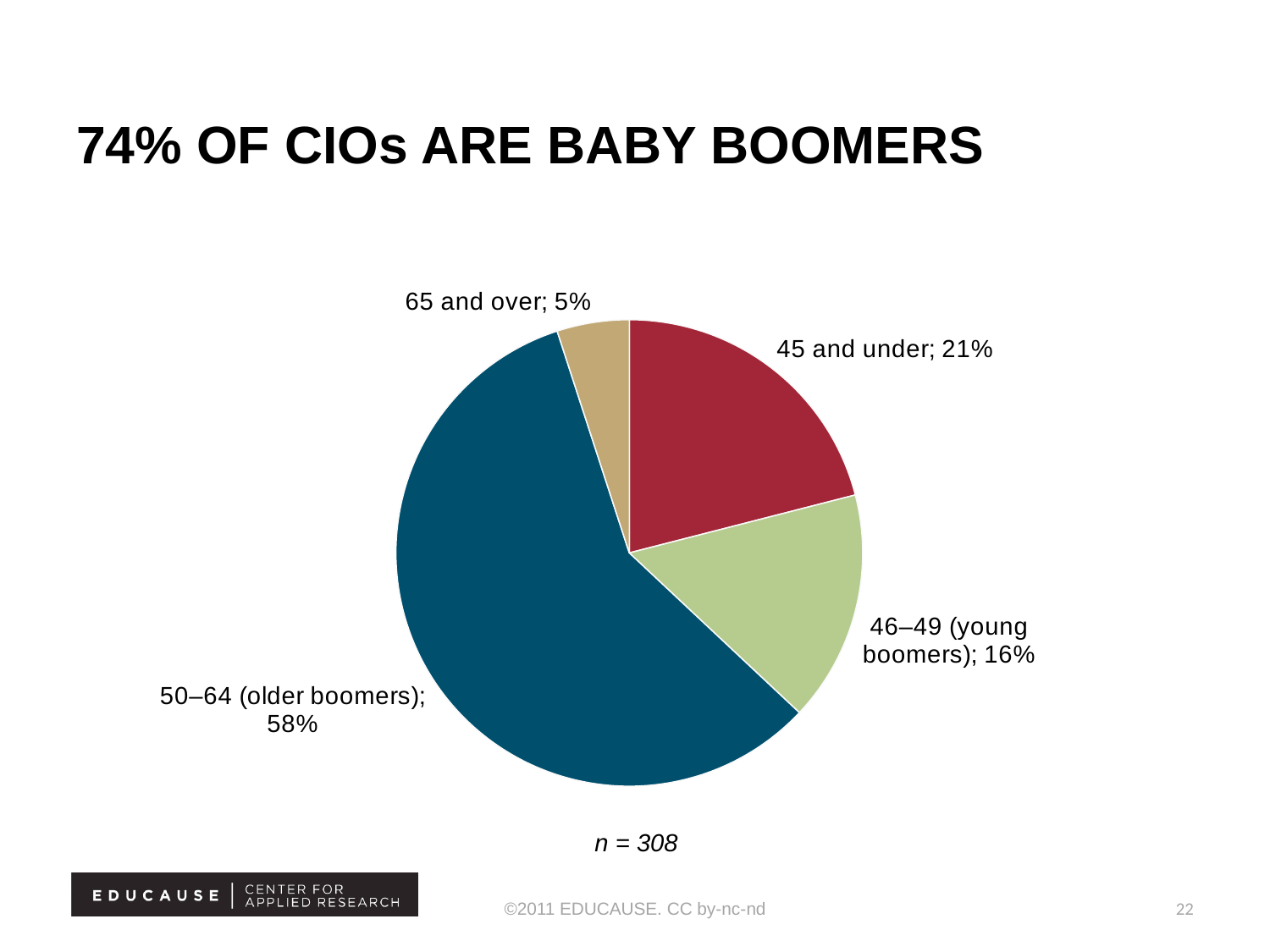
Which age group has the largest slice of the pie? 50–64 (older boomers) What kind of chart is shown on the slide? pie chart What is the difference in percentage points between the 50–64 (older boomers) slice and the 45 and under slice? 37 What share of CIOs are 50–64 (older boomers)? 58% What is the combined share of the 46–49 (young boomers) and 50–64 (older boomers) slices? 74% What share of CIOs are 46–49 (young boomers)? 16% Which age group has the smallest slice of the pie? 65 and over What is the sample size (n) shown below the pie chart? n = 308 How many slices does the pie chart have? 4 What share of CIOs are 65 and over? 5% Which is larger, the 45 and under slice or the 46–49 (young boomers) slice? 45 and under What share of CIOs are 45 and under? 21%